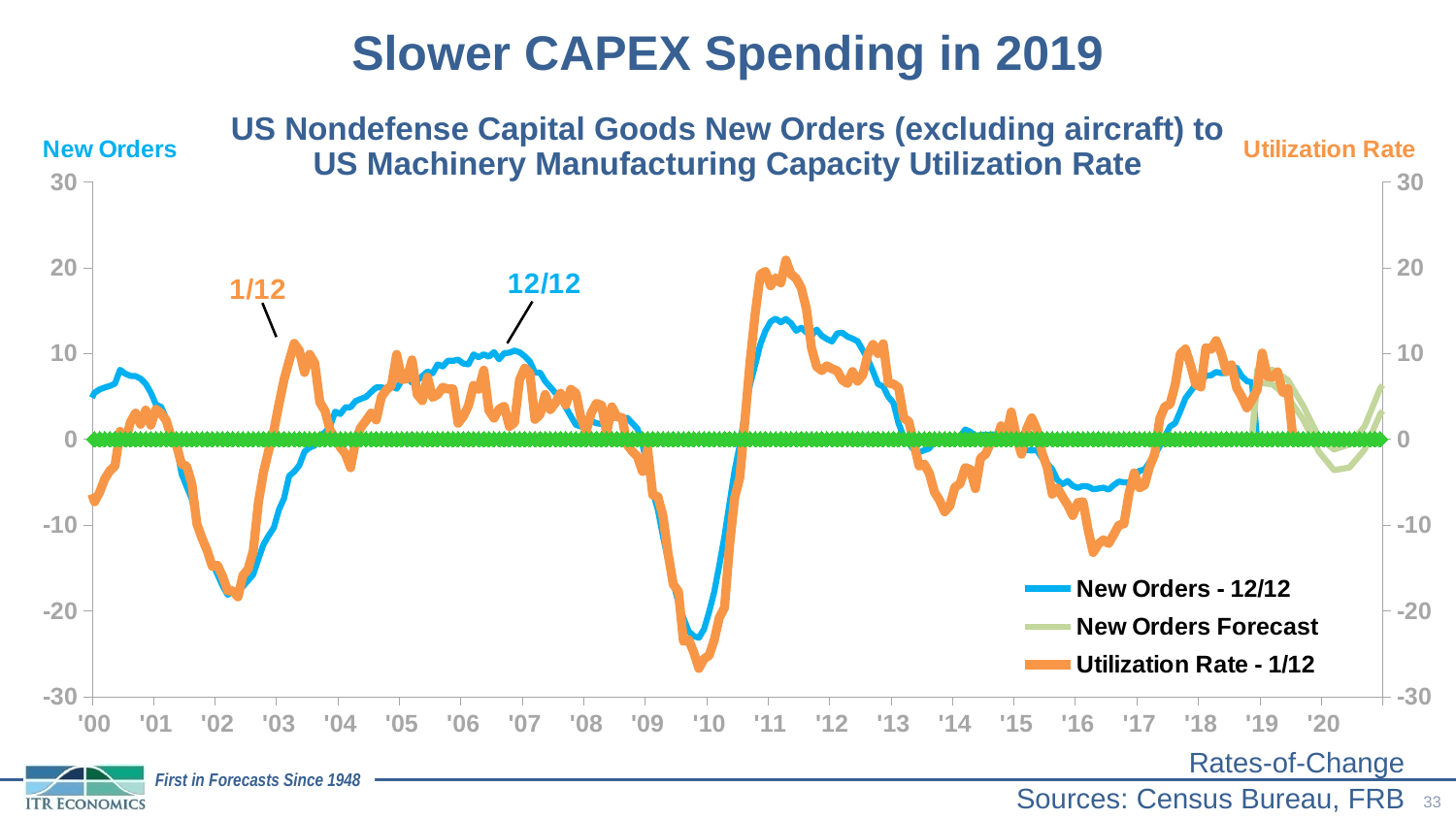
Which series is shown in orange according to the legend? Utilization Rate - 1/12 Is the value of the New Orders - 12/12 series at its trough around '02 greater or less than -10? less At the peak around '11, which series reaches the higher value: New Orders - 12/12 or Utilization Rate - 1/12? Utilization Rate - 1/12 Is the peak value of the New Orders - 12/12 series around '11 greater or less than 10? greater What is the title of the chart? US Nondefense Capital Goods New Orders (excluding aircraft) to US Machinery Manufacturing Capacity Utilization Rate What kind of chart is shown on the slide? line chart Is the value of the Utilization Rate - 1/12 series at its trough around '16 greater or less than -10? less How many year labels are shown on the x axis? 21 At the trough around '10, which series reaches the lower value: New Orders - 12/12 or Utilization Rate - 1/12? Utilization Rate - 1/12 How many series does the legend list? 3 Does the New Orders - 12/12 series rise or fall between '09 and '11? rise